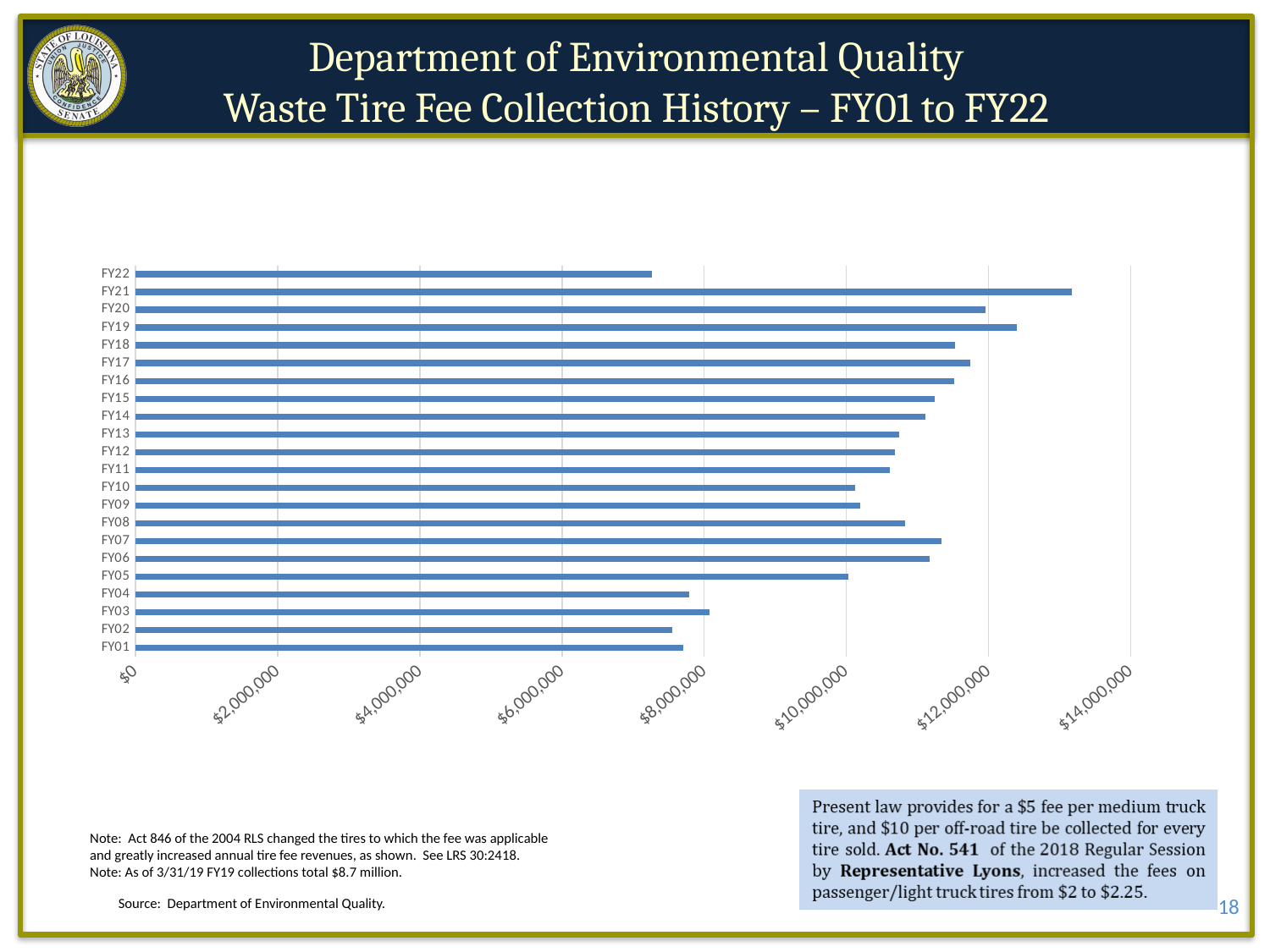
Is the value for FY21 greater or less than $12,000,000? greater Did waste tire fee collections rise or fall from FY21 to FY22? fall Which is larger, the value for FY21 or the value for FY22? FY21 Is the value for FY07 greater or less than $10,000,000? greater What is the highest value labelled on the horizontal axis of the chart? $14,000,000 Is the value for FY22 greater or less than $8,000,000? less Which fiscal year has the highest waste tire fee collection? FY21 What kind of chart is shown on the slide? Bar chart How many fiscal years are plotted in the chart? 22 Which is larger, the value for FY04 or the value for FY05? FY05